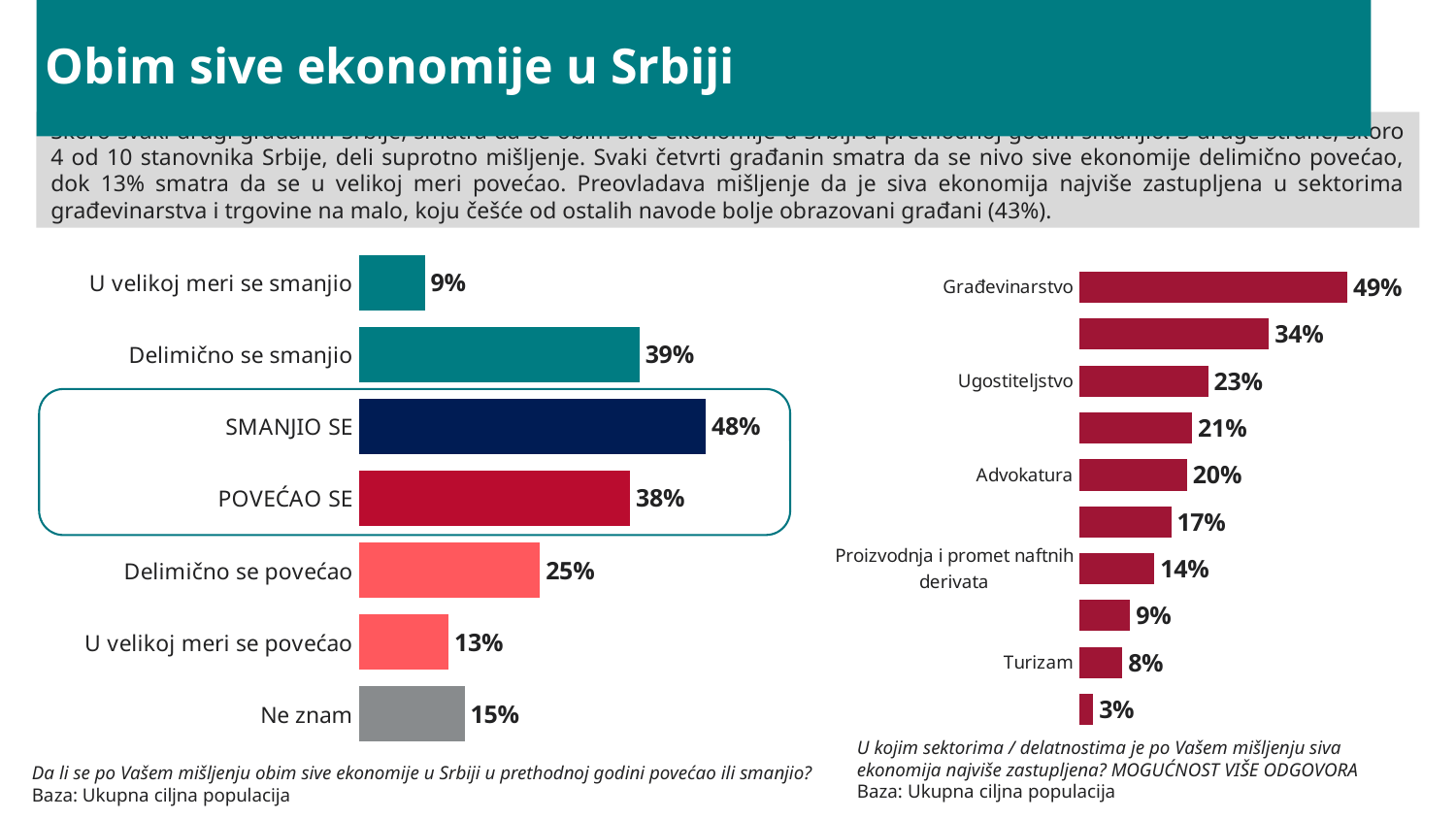
In the left chart, what is the value for "Ne znam"? 15% What type of chart is the right chart? Bar chart In the left chart, what is the value for "Delimično se smanjio"? 39% In the left chart, which is larger: "Delimično se povećao" or "U velikoj meri se povećao"? Delimično se povećao In the left chart, what is the difference between "SMANJIO SE" and "POVEĆAO SE"? 10% In the right chart, what is the difference between "Ugostiteljstvo" and "Proizvodnja i promet naftnih derivata"? 9% In the left chart, which category has the highest value? SMANJIO SE In the right chart, what is the value for "Građevinarstvo"? 49% In the right chart, what is the value for "Advokatura"? 20% In the right chart, what is the value for "Turizam"? 8% How many categories are shown in the left chart? 7 In the left chart, which category has the lowest value? U velikoj meri se smanjio